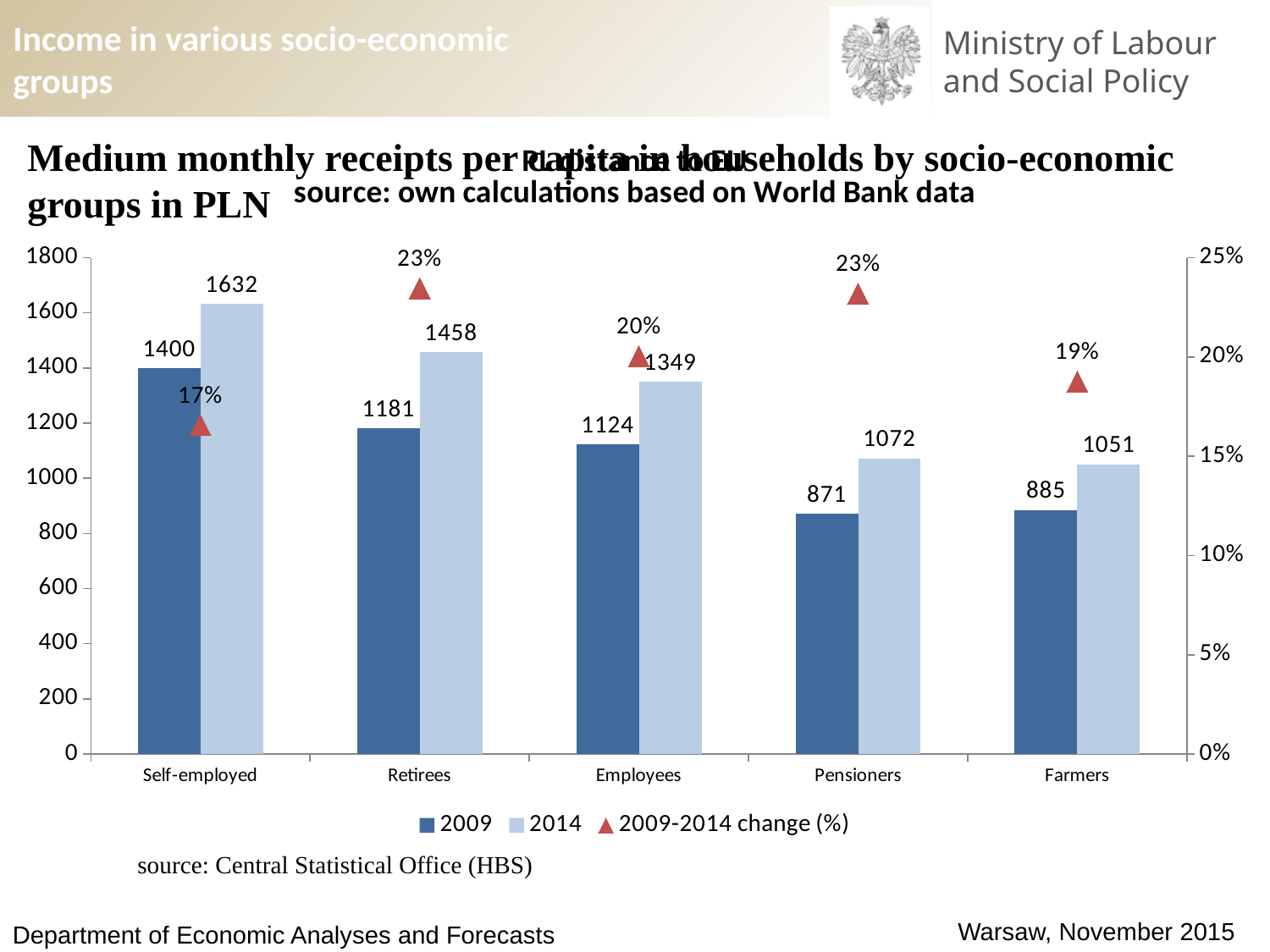
What was the value for Self-employed in 2014? 1632 Which socio-economic group had the lowest value in 2009? Pensioners What was the value for Pensioners in 2009? 871 Which is larger: the 2014 value for Employees or the 2014 value for Retirees? Retirees What is the 2009-2014 change (%) shown for Farmers? 19% How many series does the legend list? 3 How many socio-economic groups are shown on the x axis? 5 Is the 2009 value for Farmers greater or less than 1000? less What is the difference between the 2014 and 2009 values for Retirees? 277 What kind of chart is used to show the 2009 and 2014 values? bar chart Which socio-economic group had the highest value in 2014? Self-employed What is the source given below the chart? Central Statistical Office (HBS)